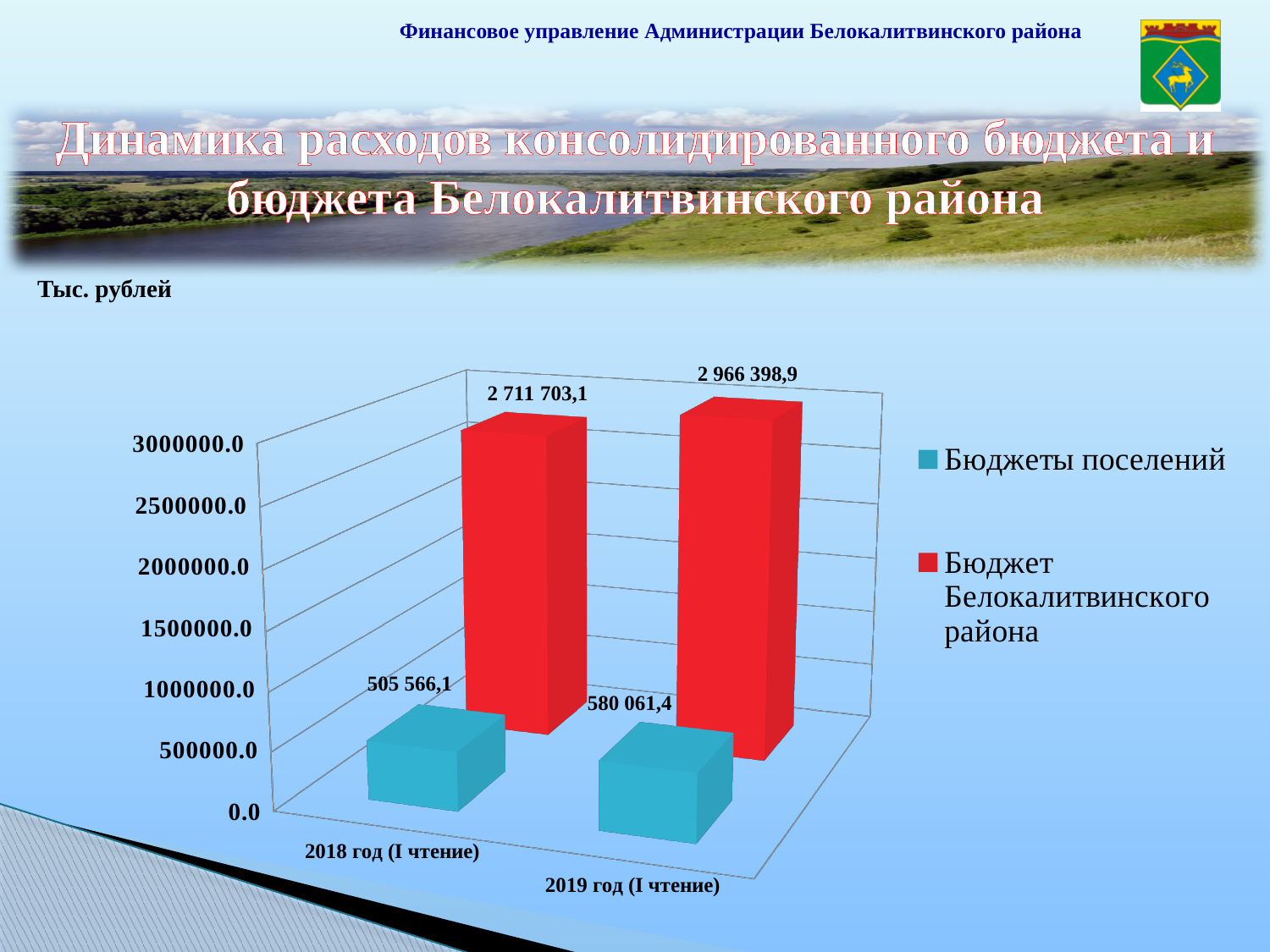
What is the value for Бюджеты поселений in 2019 год (I чтение)? 580 061,4 Which is larger in 2019 год (I чтение): Бюджеты поселений or Бюджет Белокалитвинского района? Бюджет Белокалитвинского района Which category has the lowest value for Бюджеты поселений? 2018 год (I чтение) How many series does the legend list? 2 What is the difference between Бюджеты поселений in 2019 год (I чтение) and 2018 год (I чтение)? 74 495,3 Do the values for Бюджеты поселений rise or fall from 2018 год (I чтение) to 2019 год (I чтение)? rise What is the value for Бюджет Белокалитвинского района in 2019 год (I чтение)? 2 966 398,9 What is the value for Бюджеты поселений in 2018 год (I чтение)? 505 566,1 By how much does Бюджет Белокалитвинского района increase from 2018 год (I чтение) to 2019 год (I чтение)? 254 695,8 What is the value for Бюджет Белокалитвинского района in 2018 год (I чтение)? 2 711 703,1 What kind of chart is shown on the slide? bar chart Which category has the highest value for Бюджет Белокалитвинского района? 2019 год (I чтение)